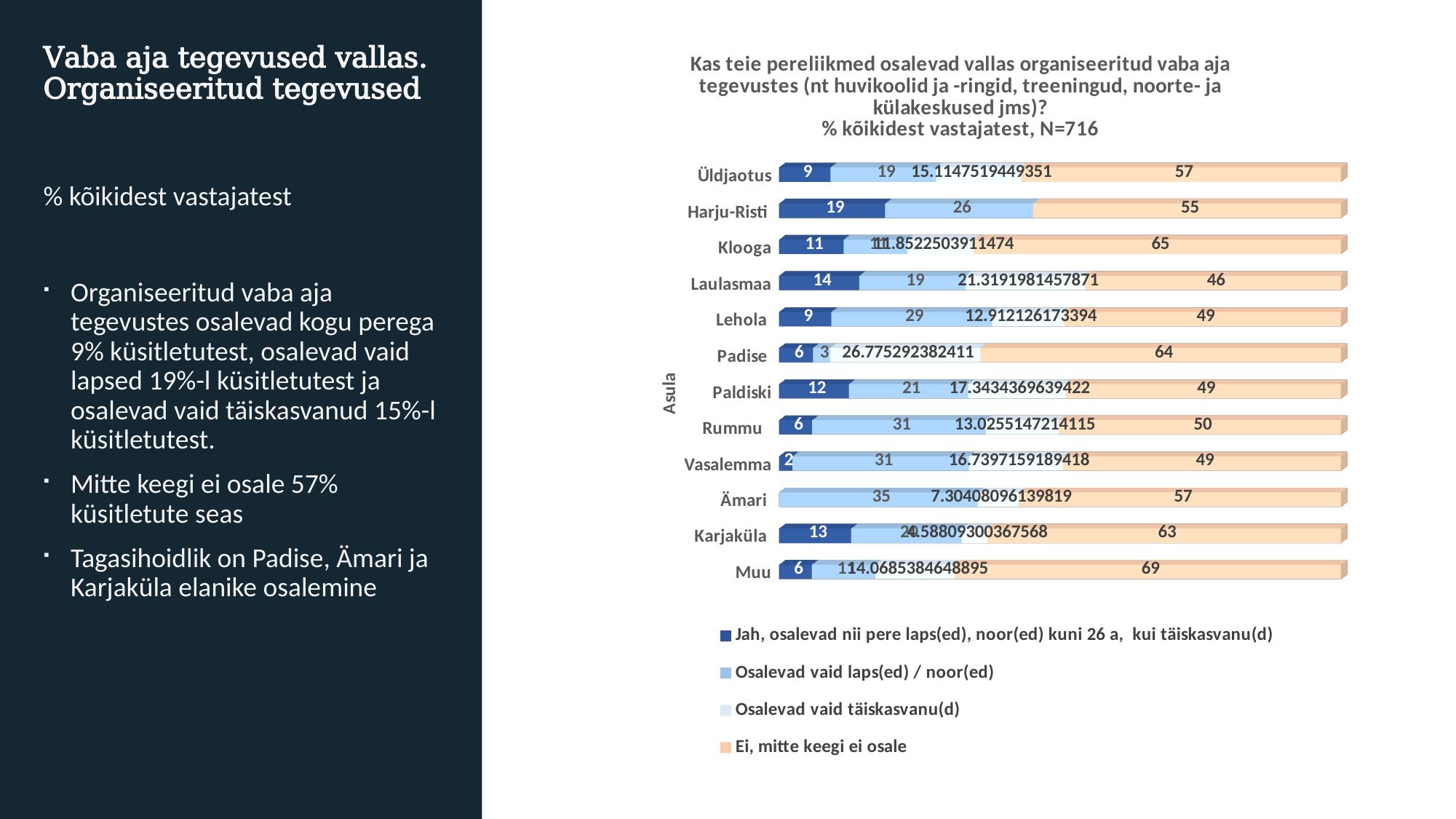
Which category has the lowest value for 'Ei, mitte keegi ei osale'? Laulasmaa What kind of chart is shown on the slide? bar chart Which has a larger 'Ei, mitte keegi ei osale' value, Klooga or Harju-Risti? Klooga What is the value of 'Ei, mitte keegi ei osale' for Klooga? 65 What is the value of 'Ei, mitte keegi ei osale' for Üldjaotus? 57 How many categories (asula) are shown on the y axis? 12 Which category has the highest value for 'Ei, mitte keegi ei osale'? Muu How many series does the legend list? 4 What is the difference between the 'Ei, mitte keegi ei osale' values for Muu and Laulasmaa? 23 What is the value of 'Osalevad vaid laps(ed) / noor(ed)' for Ämari? 35 What is the N (number of respondents) stated in the chart title? 716 What is the value of 'Jah, osalevad nii pere laps(ed), noor(ed) kuni 26 a, kui täiskasvanu(d)' for Harju-Risti? 19